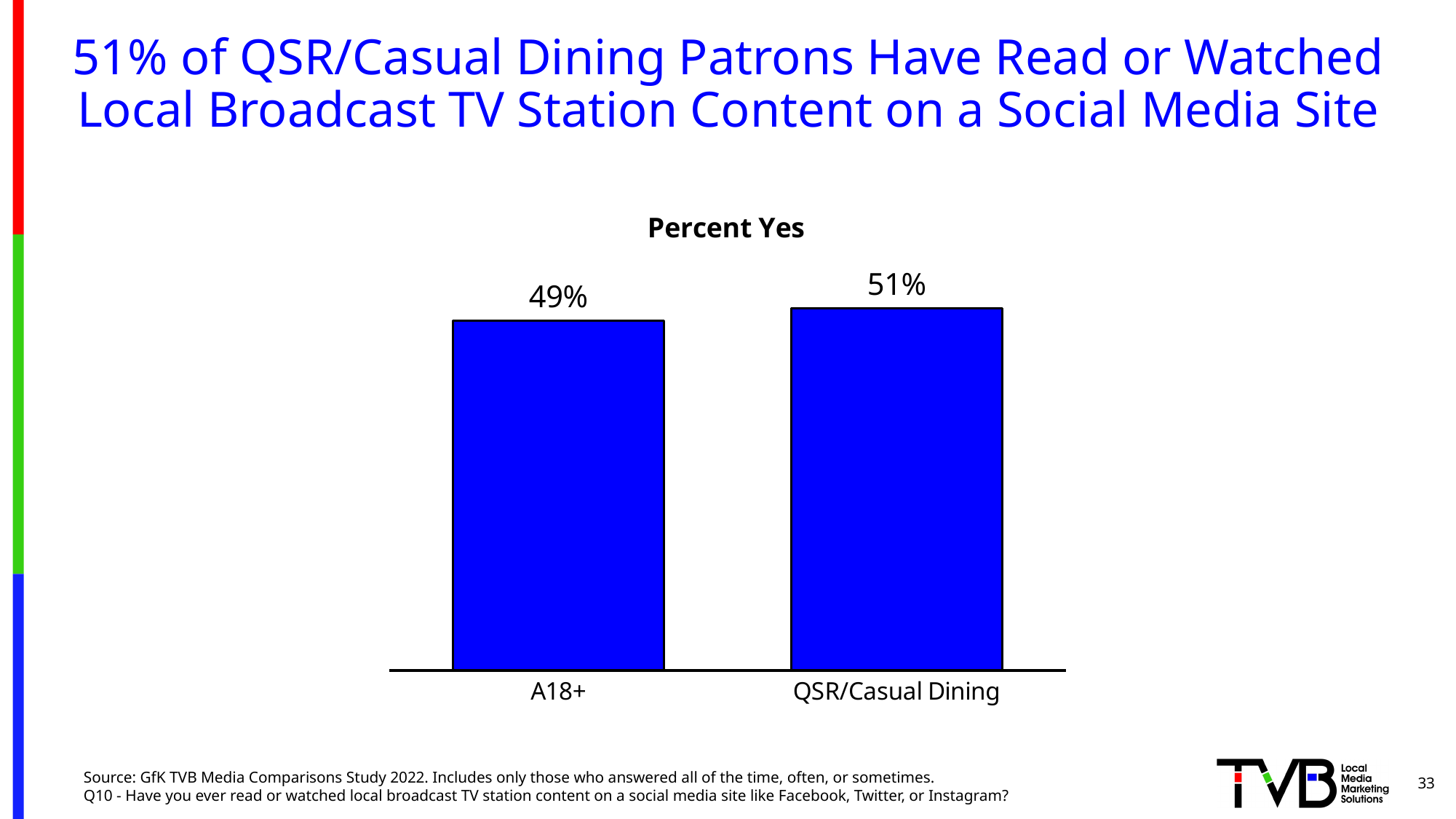
How many categories are shown in the chart? 2 What is the value for QSR/Casual Dining? 51% Which is larger, the value for A18+ or the value for QSR/Casual Dining? QSR/Casual Dining What is the value for A18+? 49% What is the title of the chart? Percent Yes Which category has the highest value? QSR/Casual Dining What kind of chart is shown on the slide? Bar chart Which category has the lowest value? A18+ What is the difference between the values for QSR/Casual Dining and A18+? 2% What colour are the bars in the chart? Blue